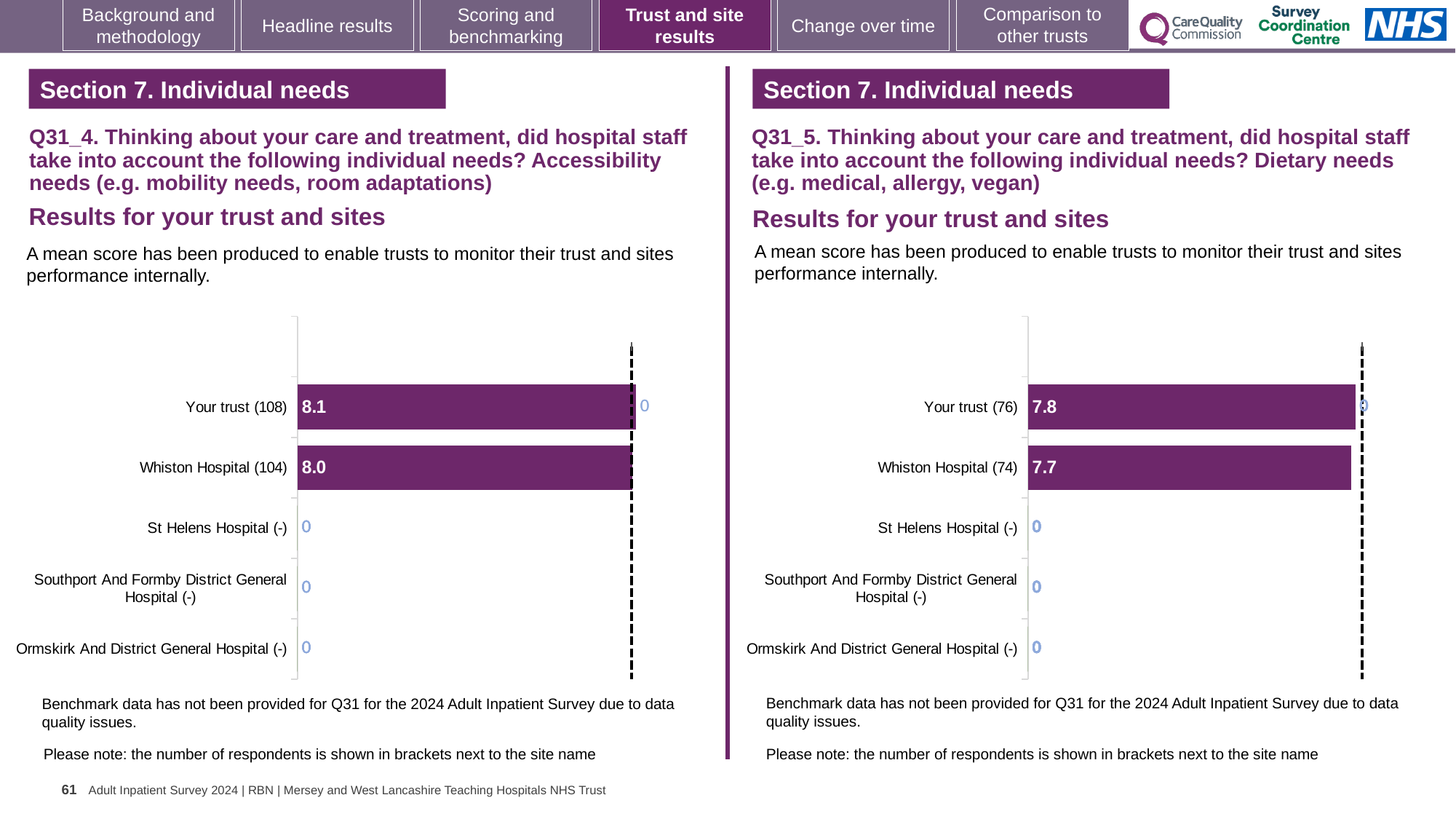
In the left chart (Q31_4, accessibility needs), what is the difference between the scores for Your trust and Whiston Hospital? 0.1 In the left chart (Q31_4, accessibility needs), what is the mean score for Whiston Hospital (104)? 8.0 In the left chart (Q31_4, accessibility needs), how many respondents are shown for Your trust? 108 In the right chart (Q31_5, dietary needs), what is the difference between the scores for Your trust and Whiston Hospital? 0.1 In the right chart (Q31_5, dietary needs), how many respondents are shown for Whiston Hospital? 74 In the left chart (Q31_4, accessibility needs), what is the mean score for Your trust (108)? 8.1 What type of chart is used on the right (Q31_5, dietary needs)? bar chart How many site/trust categories are listed on the left chart (Q31_4)? 5 In the right chart (Q31_5, dietary needs), what is the mean score for Your trust (76)? 7.8 In the left chart (Q31_4, accessibility needs), which site has the highest mean score among those with data? Your trust (108) Is the Your trust score for accessibility needs (left chart) higher or lower than the Your trust score for dietary needs (right chart)? higher In the right chart (Q31_5, dietary needs), what is the mean score for Whiston Hospital (74)? 7.7